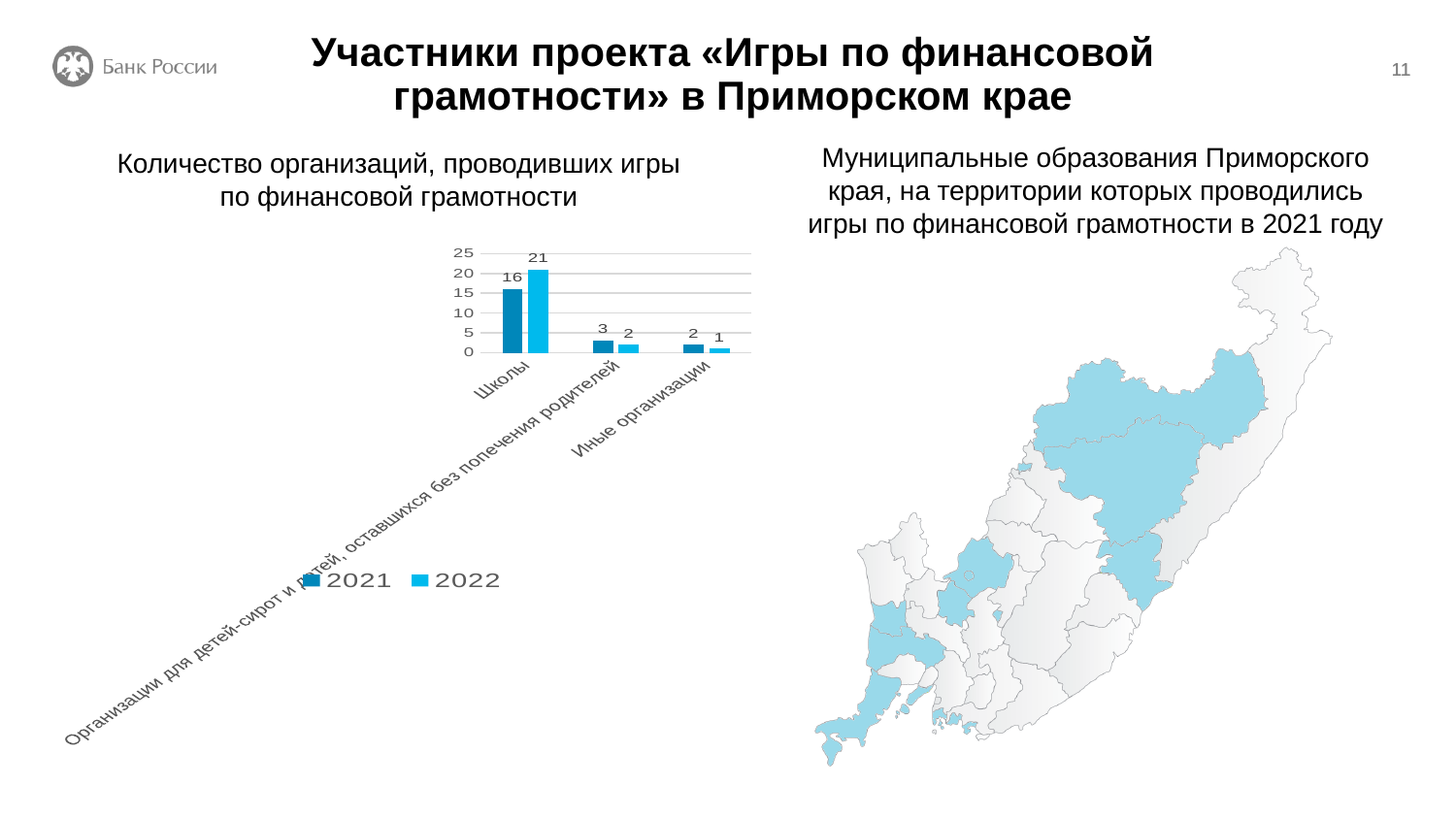
Which category has the highest value in 2022? Школы What is the value for Иные организации in 2022? 1 How many series does the legend of the bar chart list? 2 For Иные организации, which year has the larger value, 2021 or 2022? 2021 What is the difference between the 2022 and 2021 values for Школы? 5 What is the value for Школы in 2021? 16 What is the value for Школы in 2022? 21 What type of chart is used to show the number of organisations that held financial literacy games? bar chart What is the 2021 value for Организации для детей-сирот и детей, оставшихся без попечения родителей? 3 Which category has the lowest value in 2022? Иные организации Which two years are listed in the legend of the bar chart? 2021 and 2022 How many categories are shown on the x axis of the bar chart? 3